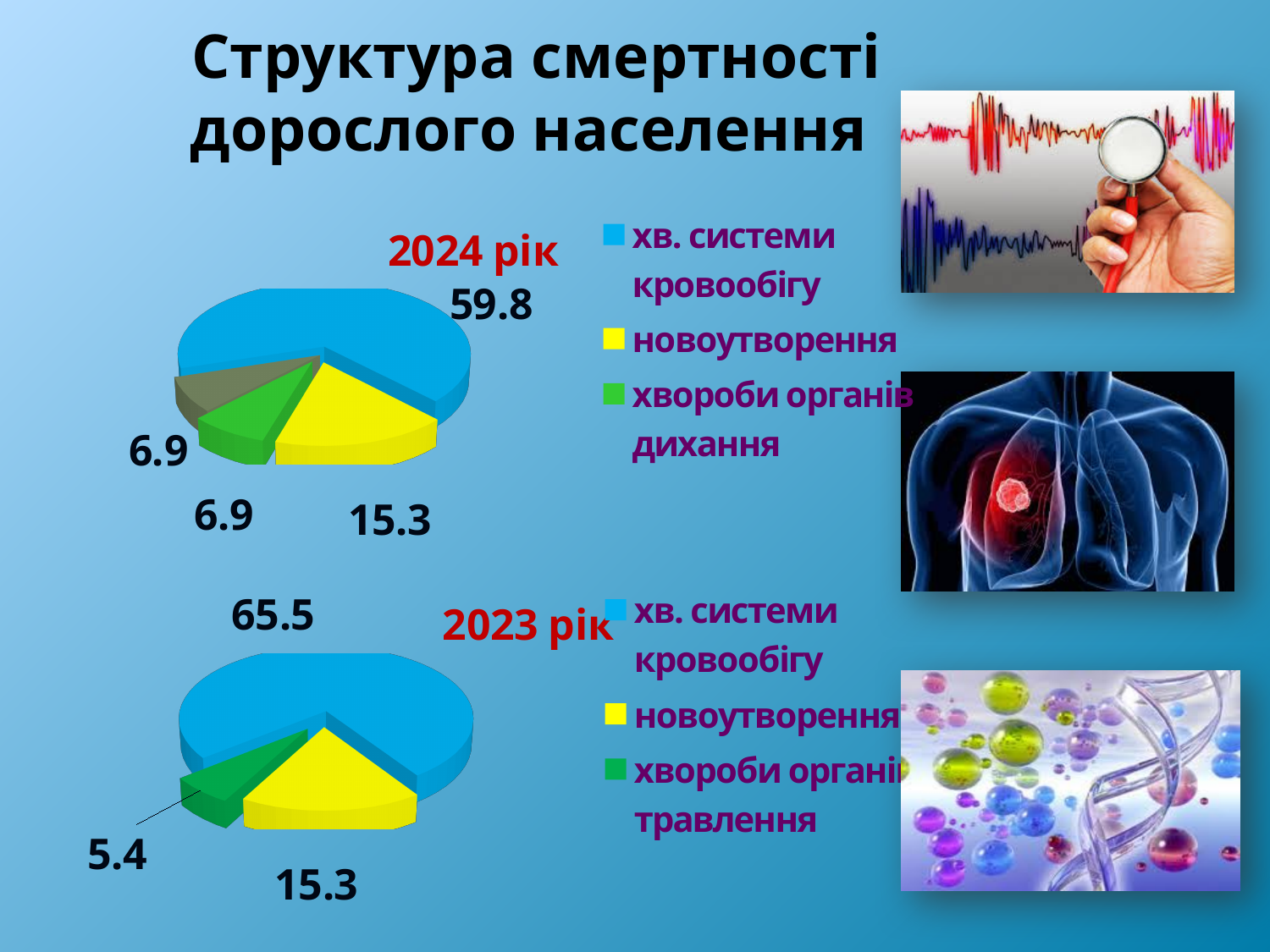
What type of chart is the 2024 рік chart? pie chart In the 2024 рік chart, what is the value for хв. системи кровообігу? 59.8 In the 2023 рік chart, which category has the largest slice? хв. системи кровообігу In the 2023 рік chart, what is the difference between the values for хв. системи кровообігу and новоутворення? 50.2 In the 2024 рік chart, which is larger: новоутворення or хвороби органів дихання? новоутворення In the 2023 рік chart, what colour is the slice for новоутворення? yellow In the 2024 рік chart, what is the value for хвороби органів дихання? 6.9 In the 2023 рік chart, what is the value for хв. системи кровообігу? 65.5 In the 2024 рік chart, what is the value for новоутворення? 15.3 In the 2023 рік chart, what is the value for хвороби органів травлення? 5.4 In the 2023 рік chart, which category has the smallest slice? хвороби органів травлення How many entries does the legend of the 2023 рік chart list? 3